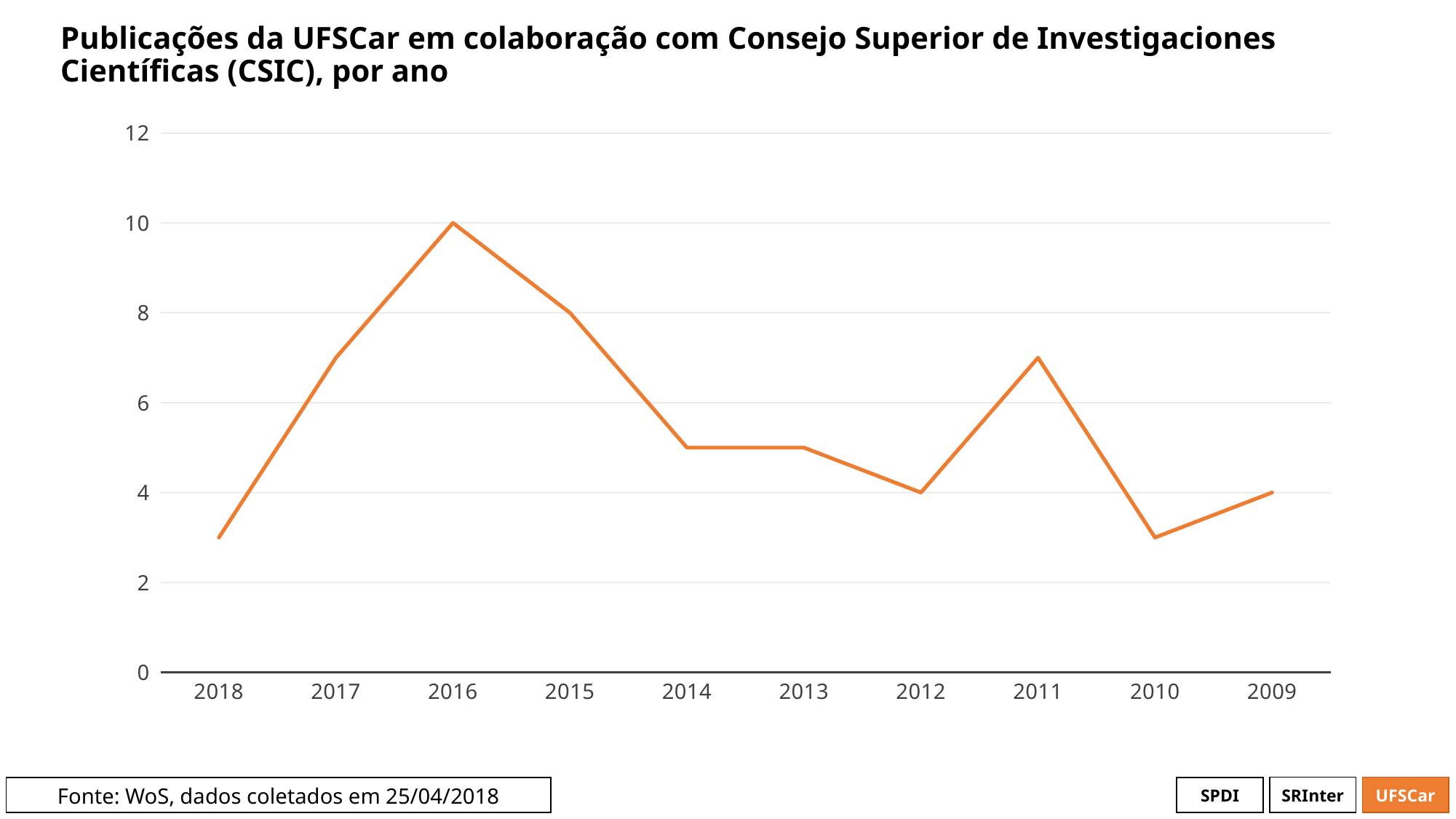
What is the value for 2012? 4 Which year has the highest value? 2016 What kind of chart is shown on the slide? line chart How many years are plotted on the x axis? 10 What is the value for 2015? 8 What is the difference between the values for 2016 and 2015? 2 What is the value for 2009? 4 Is the value for 2011 greater or less than 6? greater Is the value for 2018 greater or less than 4? less What is the value for 2016? 10 Which is larger, the value for 2016 or the value for 2011? 2016 Do the values rise or fall from 2016 to 2012 along the x axis? fall